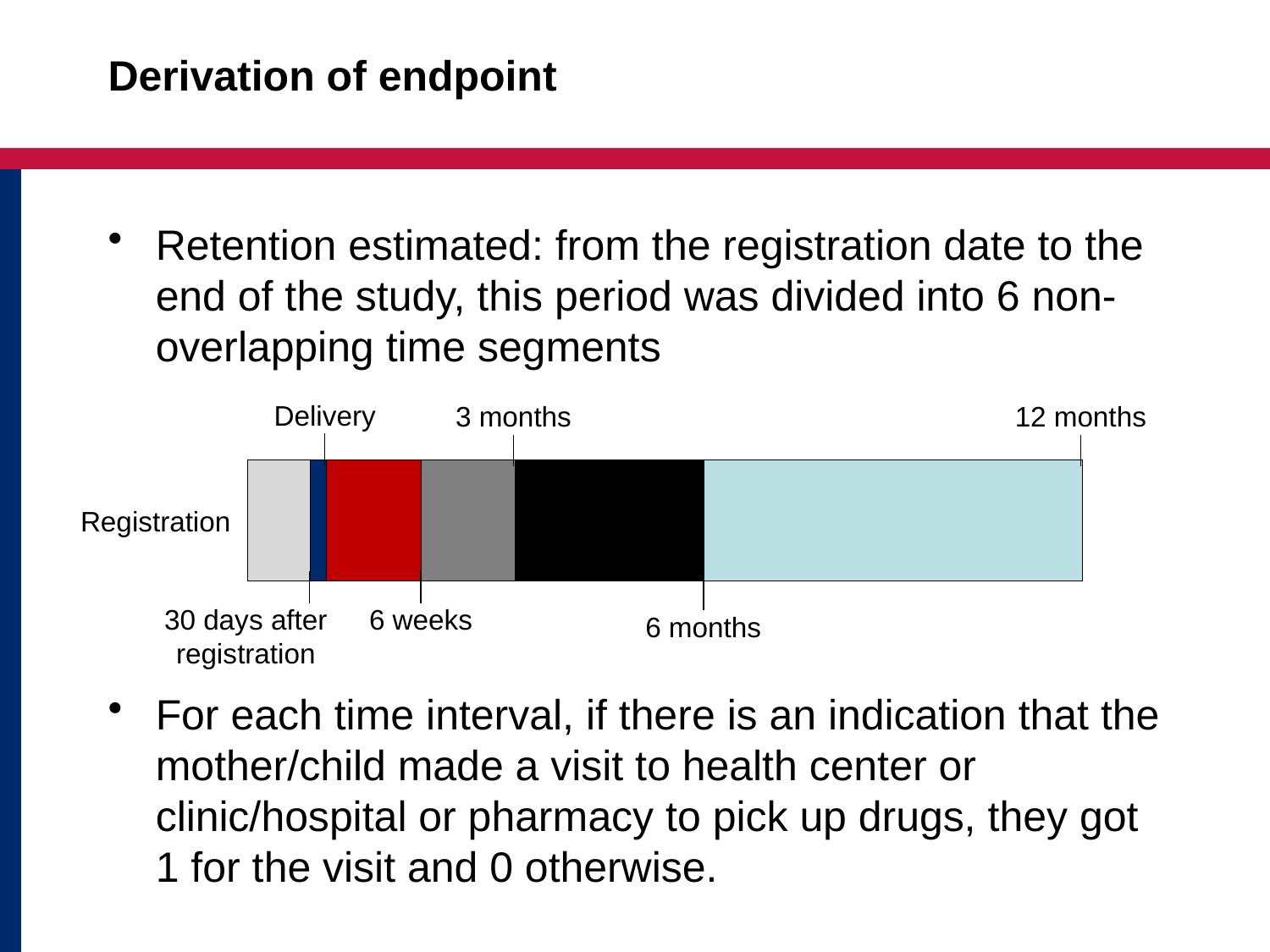
Is the segment from 3 months to 6 months wider or narrower than the segment from 6 weeks to 3 months? wider What label marks the right-hand end of the timeline bar? 12 months Which segment of the timeline bar is the narrowest? 30 days after registration to Delivery Which time point is marked on the timeline between '3 months' and '12 months'? 6 months What colour is the segment of the timeline bar between 6 months and 12 months? light blue Which segment of the timeline bar is the widest? 6 months to 12 months How many time segments does the timeline bar on the slide show? 6 What label marks the left-hand start of the timeline bar? Registration